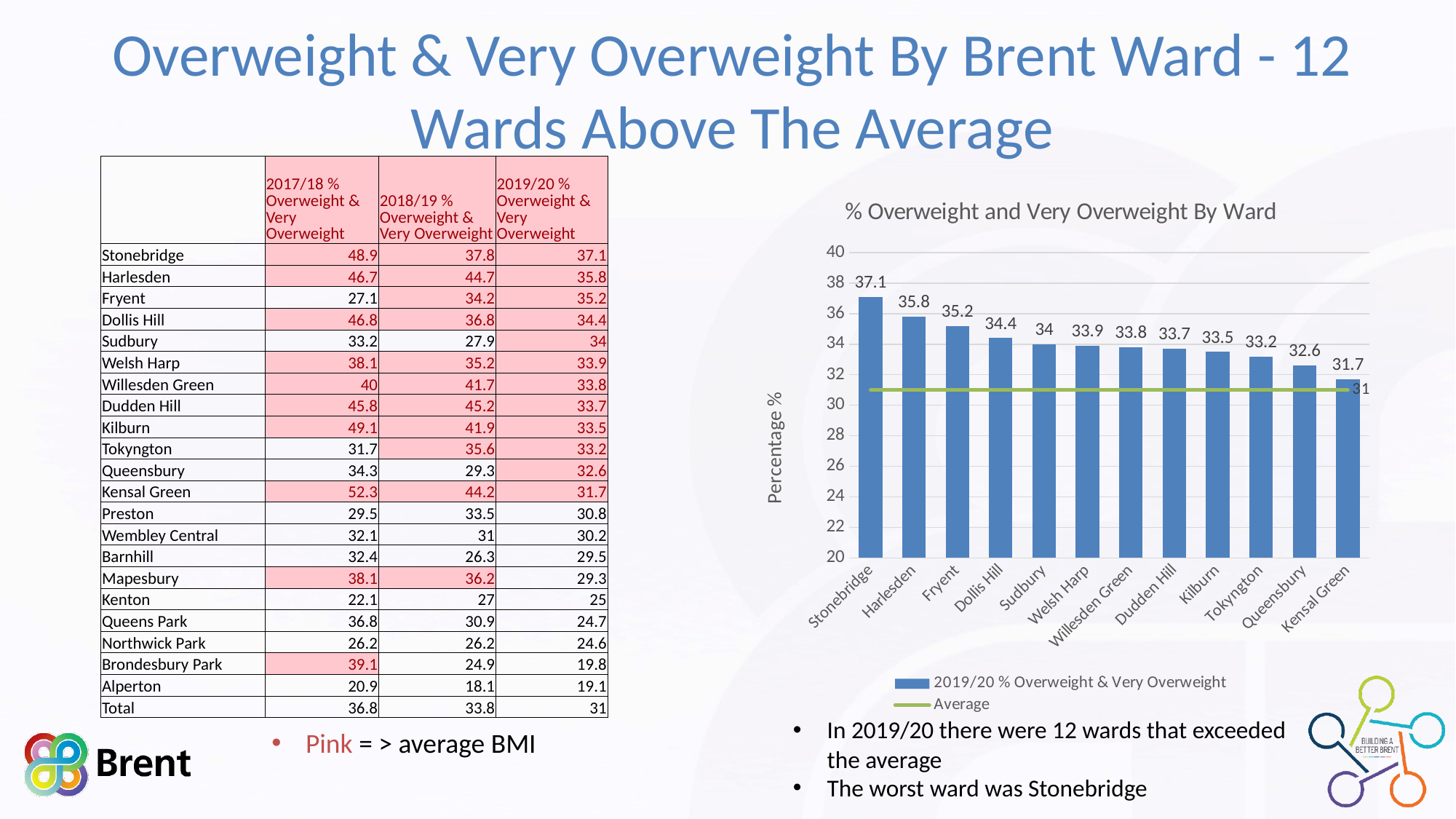
What is the value for Kensal Green in the chart? 31.7 Which ward has the lowest value in the chart? Kensal Green What is the difference between the values for Stonebridge and Harlesden? 1.3 What is the value for Kilburn in the chart? 33.5 How many wards are shown in the chart? 12 Which is larger, the value for Fryent or the value for Dollis Hill? Fryent What is the value of the Average line in the chart? 31 Is the value for Queensbury greater or less than 34? less What is the value for Stonebridge in the chart? 37.1 Which ward has the highest value in the chart? Stonebridge What kind of chart is shown on the slide? bar chart How many series does the chart legend list? 2